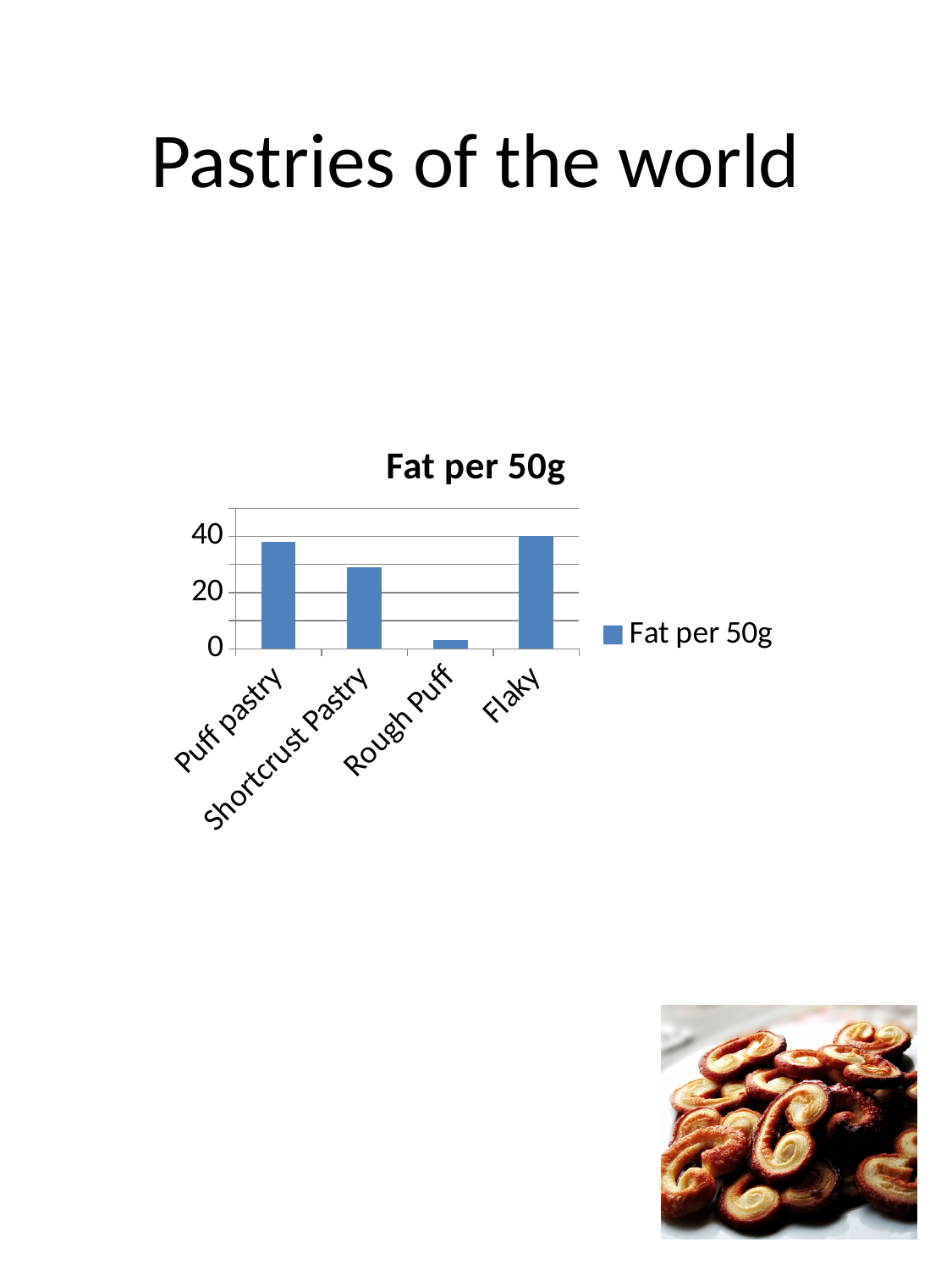
Is the value for Flaky greater or less than 20? greater How many series does the legend list? 1 Which is larger, the value for Puff pastry or the value for Shortcrust Pastry? Puff pastry How many categories are shown on the chart? 4 Is the value for Puff pastry greater or less than 20? greater What kind of chart is shown on the slide? bar chart Is the value for Shortcrust Pastry greater or less than 20? greater What is the title of the chart? Fat per 50g Which is larger, the value for Flaky or the value for Rough Puff? Flaky Which category has the lowest fat per 50g? Rough Puff What is the name of the series shown in the legend? Fat per 50g